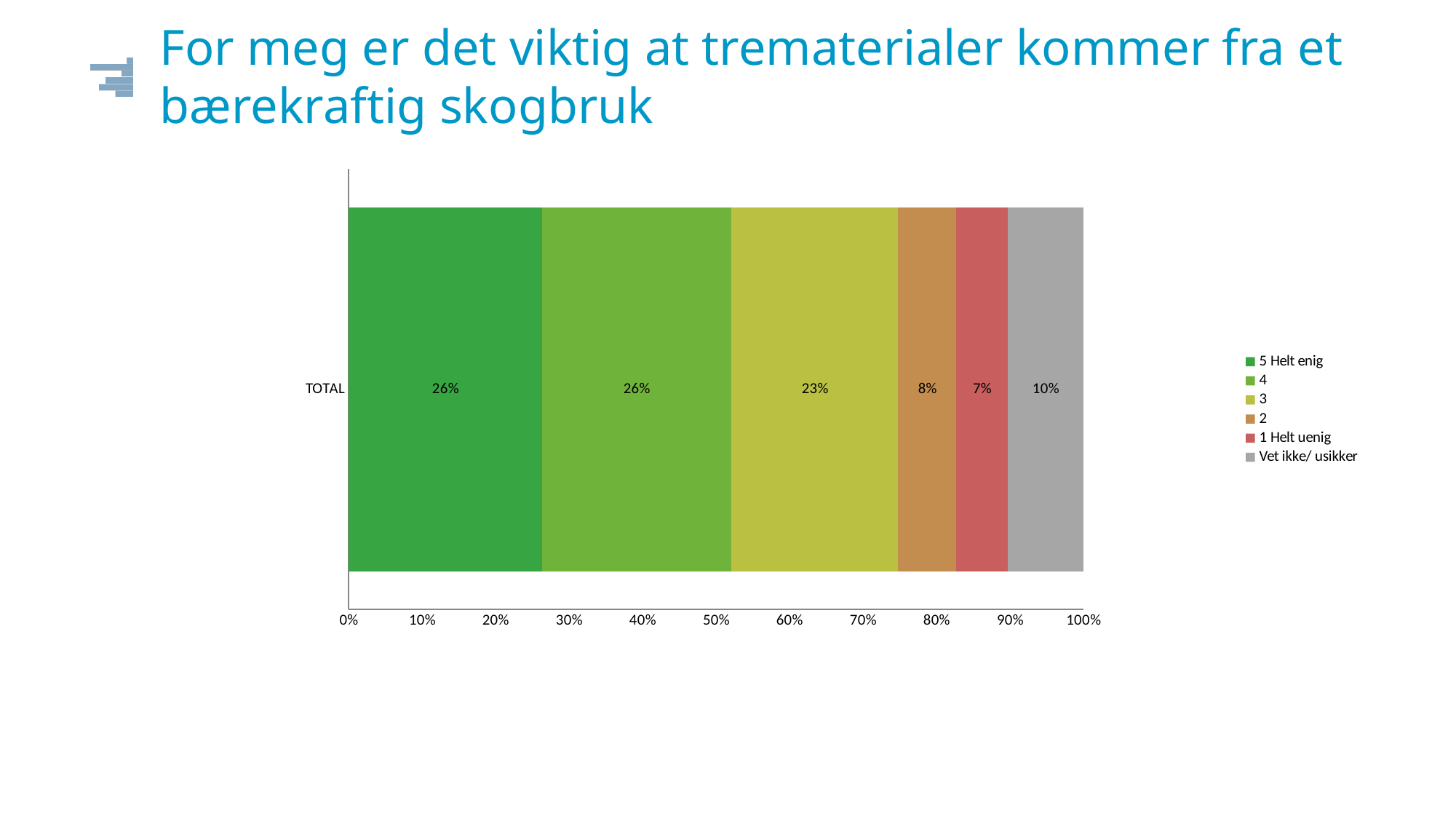
What is the value for the "5 Helt enig" segment of the TOTAL bar? 26% Which series has the smallest segment in the TOTAL bar? 1 Helt uenig What is the value for the "3" segment of the TOTAL bar? 23% How many categories are plotted on the chart? 1 How many series does the legend list? 6 What colour is the "Vet ikke/ usikker" segment? Grey What is the value for the "Vet ikke/ usikker" segment of the TOTAL bar? 10% What is the value for the "1 Helt uenig" segment of the TOTAL bar? 7% Which is larger in the TOTAL bar, the "2" segment or the "Vet ikke/ usikker" segment? Vet ikke/ usikker What kind of chart is shown on the slide? Stacked bar chart What is the difference between the "3" segment and the "2" segment in the TOTAL bar? 15% What is the combined value of the "5 Helt enig" and "4" segments in the TOTAL bar? 52%